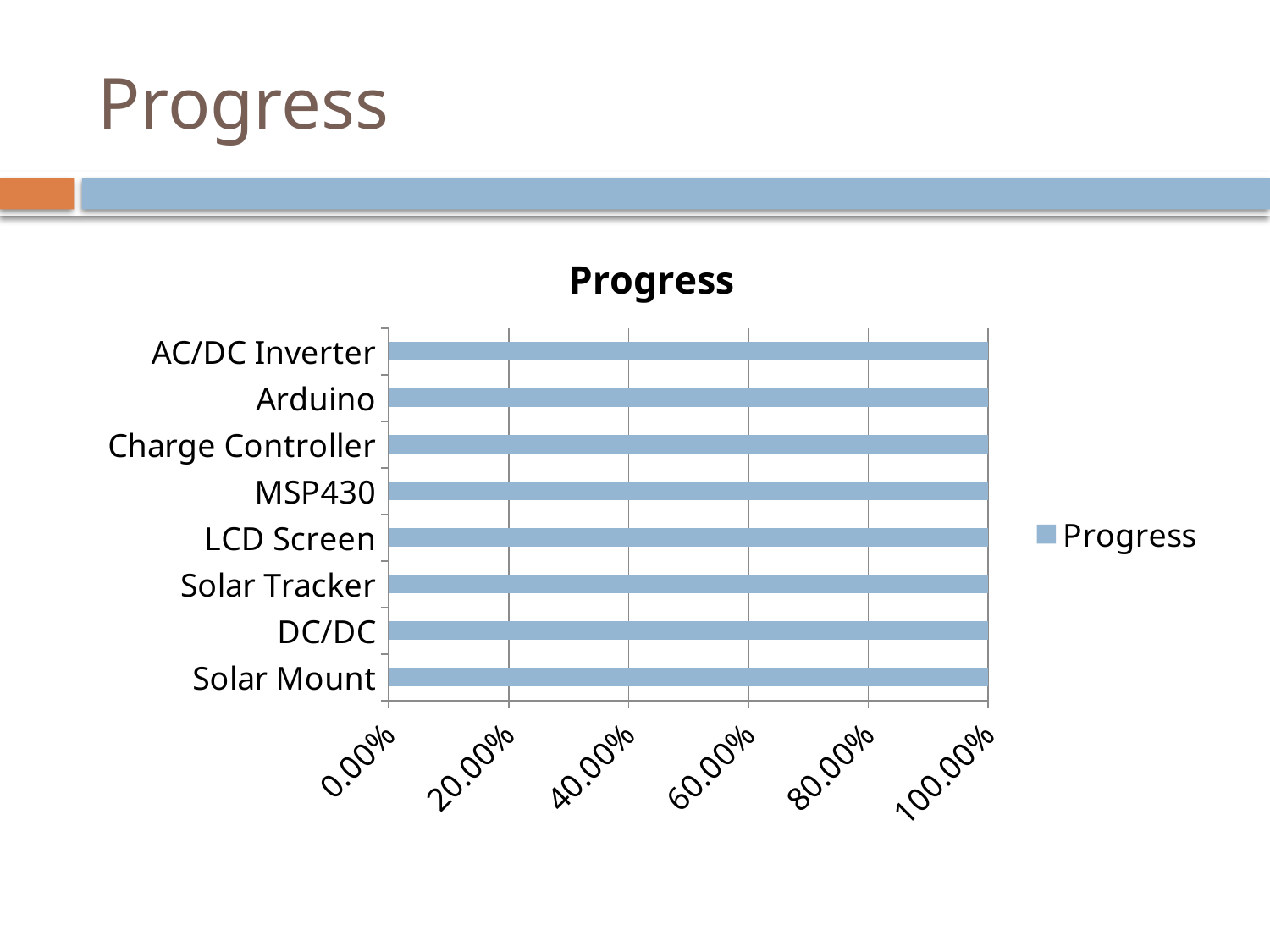
What is the value for Solar Mount? 100.00% Is the value for Solar Tracker greater or less than 80.00%? greater How many categories are plotted in the chart? 8 Is the value for Charge Controller greater or less than 40.00%? greater What kind of chart is shown on the slide? bar chart Is the value for DC/DC greater or less than 60.00%? greater What is the name of the series shown in the legend? Progress What is the value for AC/DC Inverter? 100.00% How many series does the legend list? 1 What is the value for MSP430? 100.00% What is the difference between the values for Arduino and LCD Screen? 0.00% What is the title of the chart? Progress